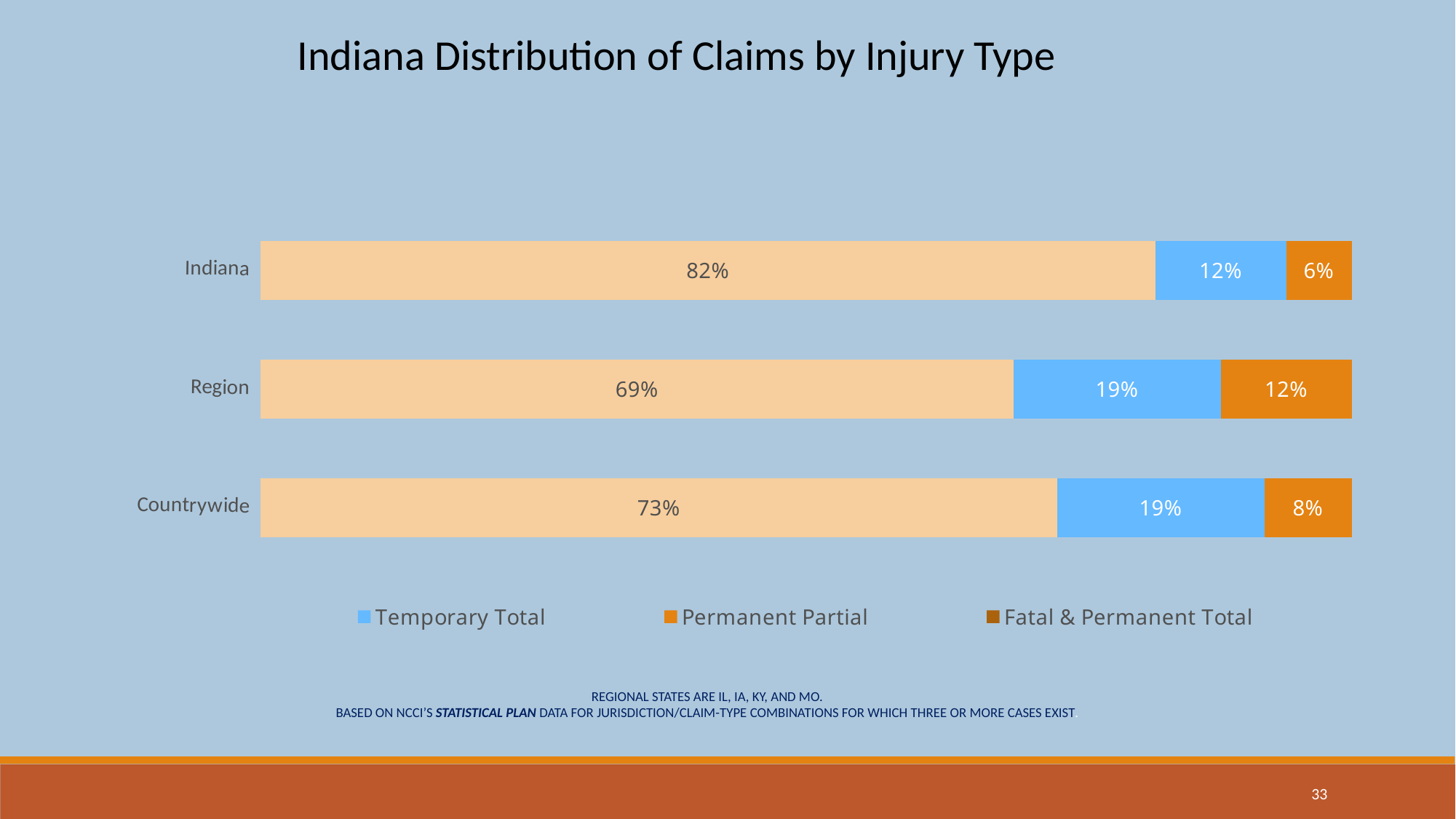
How many series does the legend list? 3 What kind of chart is shown on the slide? Stacked bar chart What is the difference between the light peach segment for Indiana and the light peach segment for Region? 13 percentage points Which category has the largest light peach segment? Indiana What is the value of the largest (light peach) segment of the Indiana bar? 82% What is the title of the chart? Indiana Distribution of Claims by Injury Type What is the value of the light blue segment of the Region bar? 19% Which is larger: the dark orange segment for Region or the dark orange segment for Indiana? Region What is the total of the three segments in the Countrywide bar? 100% How many categories (bars) are shown in the chart? 3 What is the value of the dark orange segment of the Countrywide bar? 8% Which category has the smallest light peach segment? Region